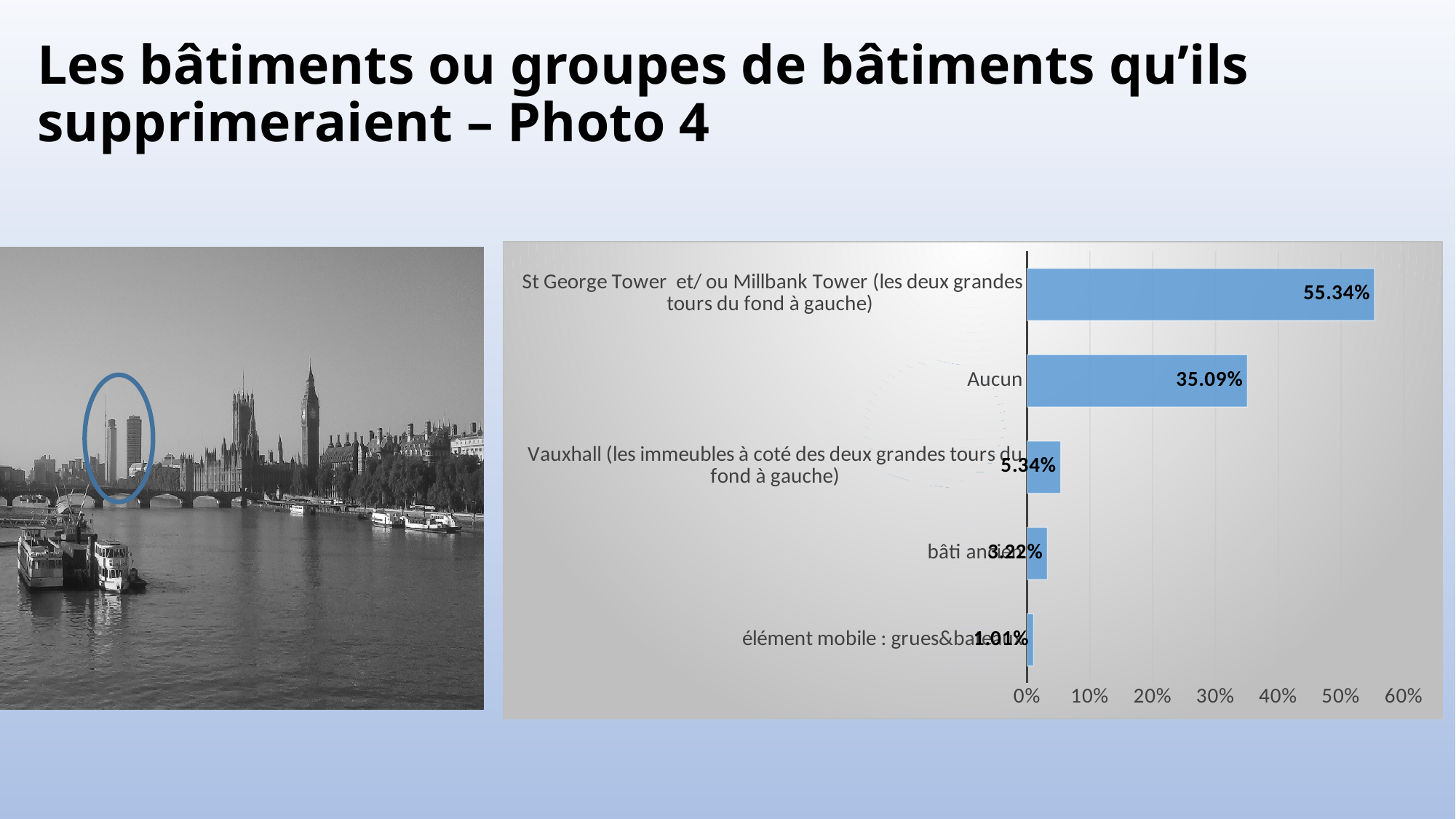
What is the difference between the percentages for "St George Tower et/ ou Millbank Tower" and "Aucun"? 20.25% How many categories are shown in the bar chart? 5 Is the value for "Aucun" greater or less than 30%? greater What kind of chart is shown on the slide? bar chart Which category has the lowest percentage? élément mobile : grues&bateaux What percentage is shown for "Aucun"? 35.09% What percentage is shown for "Vauxhall (les immeubles à coté des deux grandes tours du fond à gauche)"? 5.34% Which is larger, the value for "Aucun" or the value for "Vauxhall"? Aucun Which category has the highest percentage? St George Tower et/ ou Millbank Tower (les deux grandes tours du fond à gauche) What is the difference between the percentages for "Vauxhall" and "Aucun"? 29.75% What is the highest value shown on the horizontal axis of the chart? 60% What percentage is shown for "St George Tower et/ ou Millbank Tower"? 55.34%